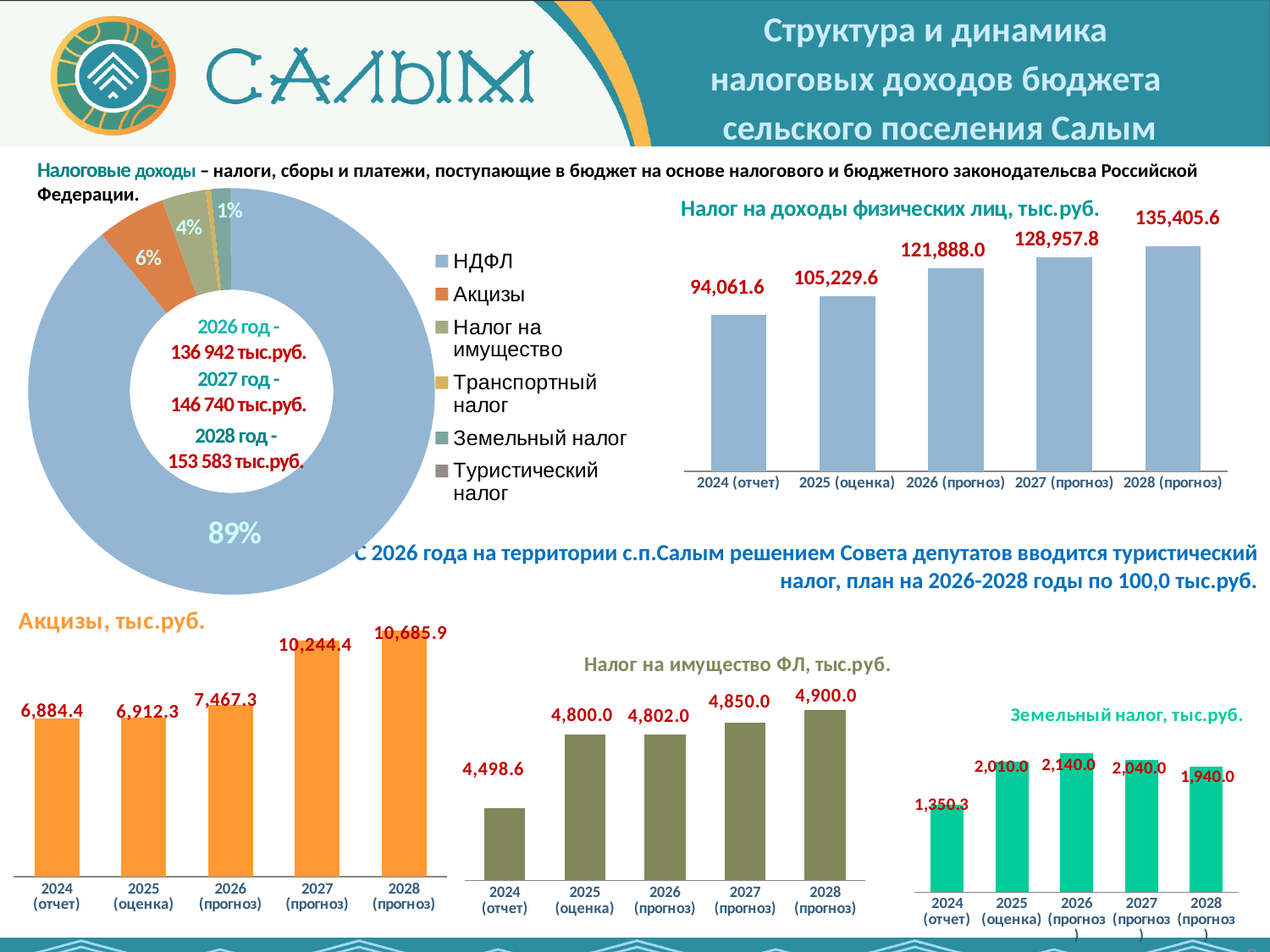
On the donut chart at the top left, what share does НДФЛ have? 89% On the chart titled 'Земельный налог, тыс.руб.', what is the difference between the 2026 (прогноз) and 2024 (отчет) values? 789.7 On the chart titled 'Налог на доходы физических лиц, тыс.руб.', what is the value for 2024 (отчет)? 94,061.6 On the chart titled 'Акцизы, тыс.руб.', which year has the highest value? 2028 (прогноз) On the chart titled 'Налог на доходы физических лиц, тыс.руб.', do the values rise or fall from 2024 to 2028? rise On the chart titled 'Налог на доходы физических лиц, тыс.руб.', what is the difference between the 2028 (прогноз) and 2024 (отчет) values? 41,344.0 On the chart titled 'Налог на доходы физических лиц, тыс.руб.', what is the value for 2028 (прогноз)? 135,405.6 On the chart titled 'Акцизы, тыс.руб.', what is the value for 2027 (прогноз)? 10,244.4 On the chart titled 'Налог на имущество ФЛ, тыс.руб.', which year has the lowest value? 2024 (отчет) On the chart titled 'Земельный налог, тыс.руб.', which year has the highest value? 2026 (прогноз) On the chart titled 'Налог на имущество ФЛ, тыс.руб.', what is the value for 2025 (оценка)? 4,800.0 How many entries does the legend of the donut chart at the top left list? 6